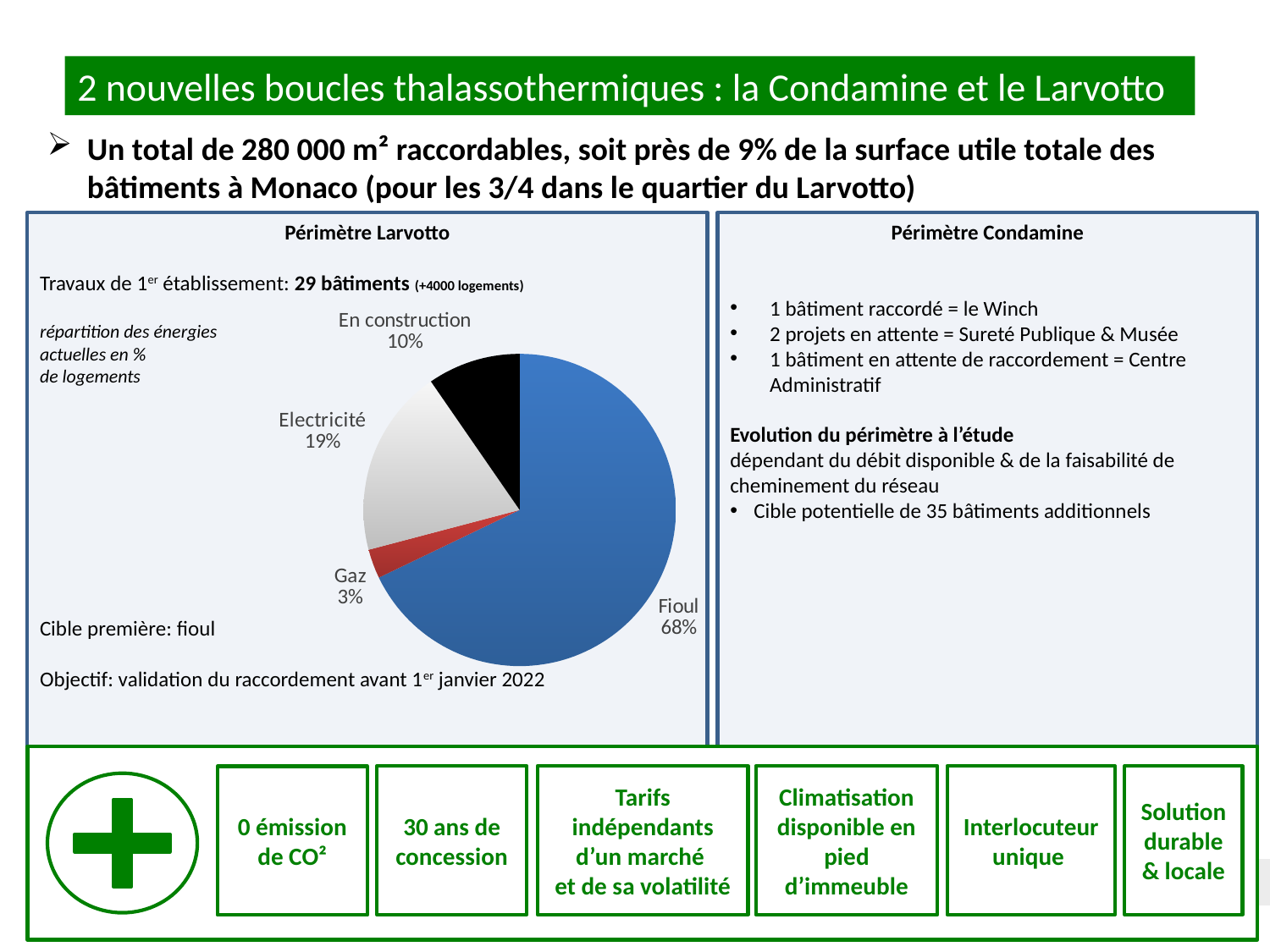
What is the difference in percentage points between the Fioul and Electricité slices? 49 What percentage of the pie chart does Gaz represent? 3% Which slice of the pie chart is the smallest? Gaz What kind of chart is shown in the Périmètre Larvotto panel? pie chart Which is larger in the pie chart, Electricité or En construction? Electricité What percentage of the pie chart does Fioul represent? 68% What percentage of the pie chart does Electricité represent? 19% What percentage of the pie chart is labelled En construction? 10% What colour is the Fioul slice of the pie chart? blue What is the combined share of the Electricité and Gaz slices? 22% How many slices does the pie chart have? 4 Which slice of the pie chart is the largest? Fioul